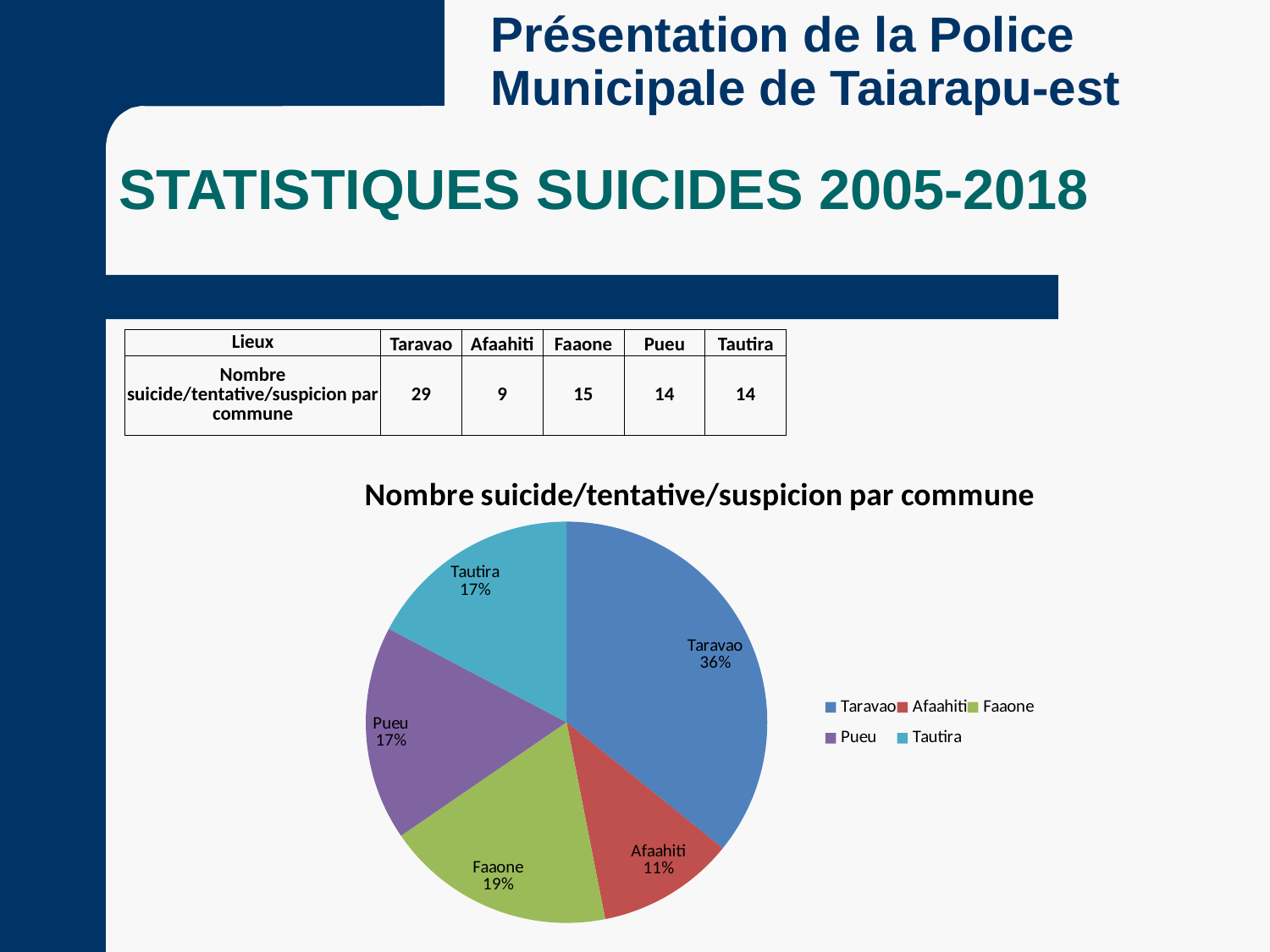
What share of the pie does Afaahiti represent? 11% What is the difference in percentage points between the Taravao slice and the Faaone slice? 17 What share of the pie does Pueu represent? 17% What share of the pie does Taravao represent? 36% Which slice is larger, Faaone or Afaahiti? Faaone Which commune has the largest slice of the pie? Taravao What is the title of the chart? Nombre suicide/tentative/suspicion par commune How many entries does the legend list? 5 Which commune has the smallest slice of the pie? Afaahiti What type of chart is shown on the slide? pie chart How many slices does the pie chart have? 5